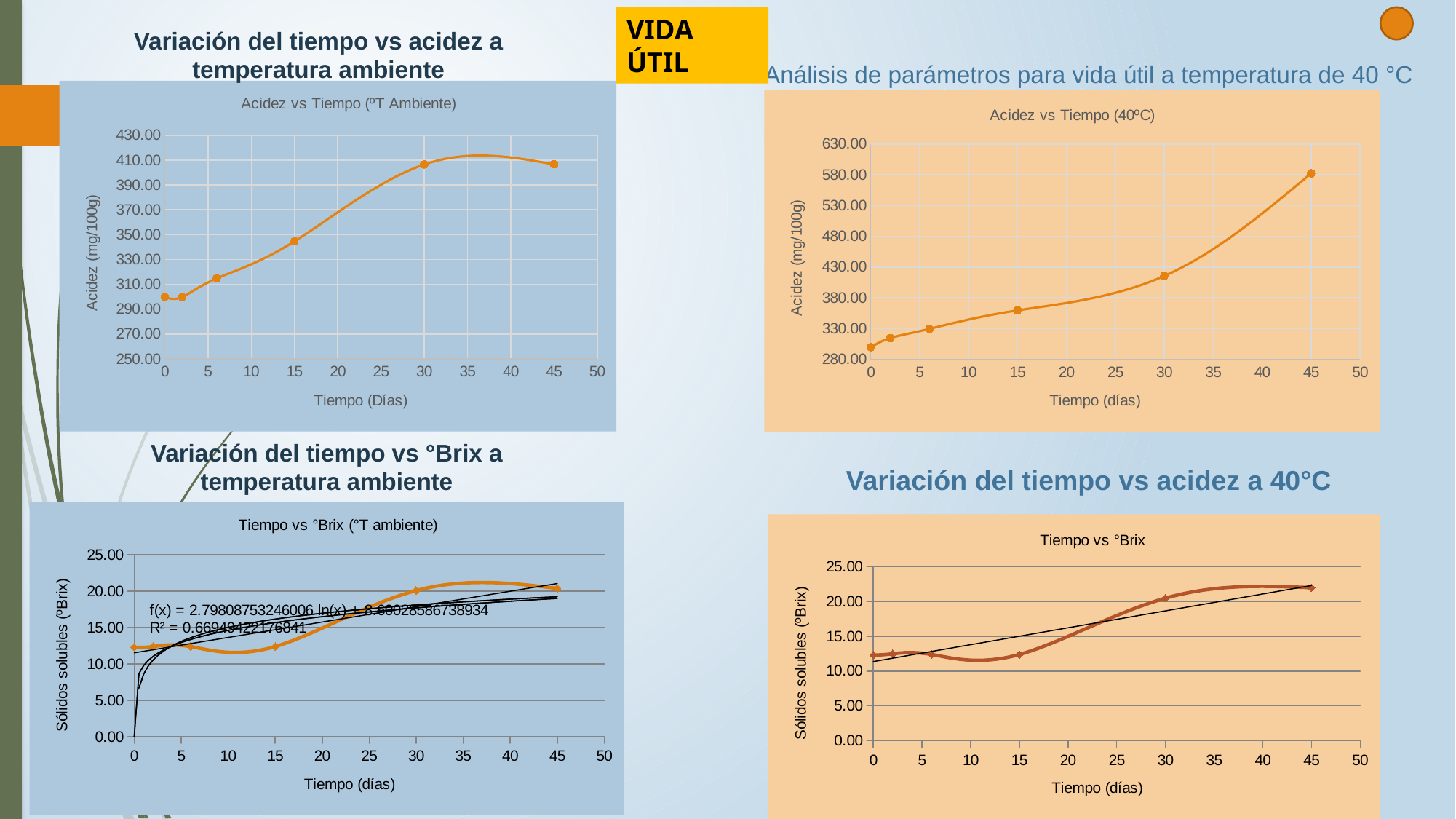
In the 'Tiempo vs °Brix (°T ambiente)' chart, is the value at 30 days greater or less than 15.00? greater In the 'Tiempo vs °Brix' chart at the bottom right, is the value at 45 days greater or less than 20.00? greater In the 'Acidez vs Tiempo (ºT Ambiente)' chart, how many data points are plotted? 6 In the 'Acidez vs Tiempo (40ºC)' chart, how many data points are plotted? 6 In the 'Tiempo vs °Brix' chart at the bottom right, is the value at 15 days greater or less than 15.00? less What is the y-axis label of the 'Acidez vs Tiempo (40ºC)' chart? Acidez (mg/100g) In the 'Acidez vs Tiempo (40ºC)' chart, do the acidity values generally rise or fall as time increases? rise In the 'Tiempo vs °Brix (°T ambiente)' chart at the bottom left, what R² value is printed on the chart? R² = 0.66949422176841 What kind of chart is the 'Acidez vs Tiempo (ºT Ambiente)' chart at the top left? Line chart